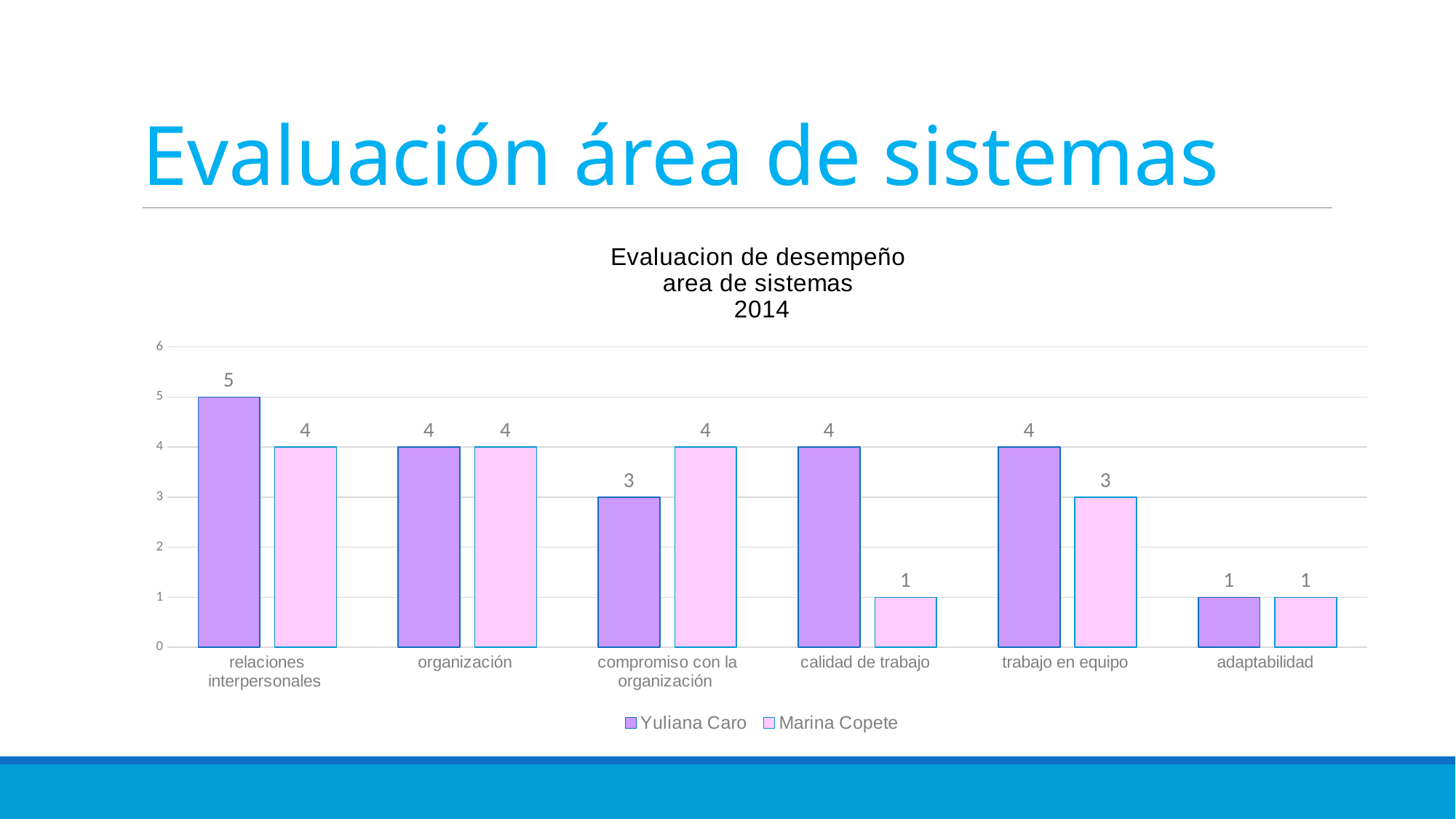
How many series does the legend list? 2 Who has the larger value in compromiso con la organización, Yuliana Caro or Marina Copete? Marina Copete What is the value for Marina Copete in calidad de trabajo? 1 What is the value for Yuliana Caro in compromiso con la organización? 3 What is the difference between Yuliana Caro and Marina Copete in calidad de trabajo? 3 In which category does Yuliana Caro have her highest value? relaciones interpersonales What is the value for Yuliana Caro in relaciones interpersonales? 5 What kind of chart is shown on the slide? bar chart What is the value for Marina Copete in trabajo en equipo? 3 How many categories are shown on the x axis? 6 In which category does Yuliana Caro have her lowest value? adaptabilidad What is the title of the chart? Evaluacion de desempeño area de sistemas 2014